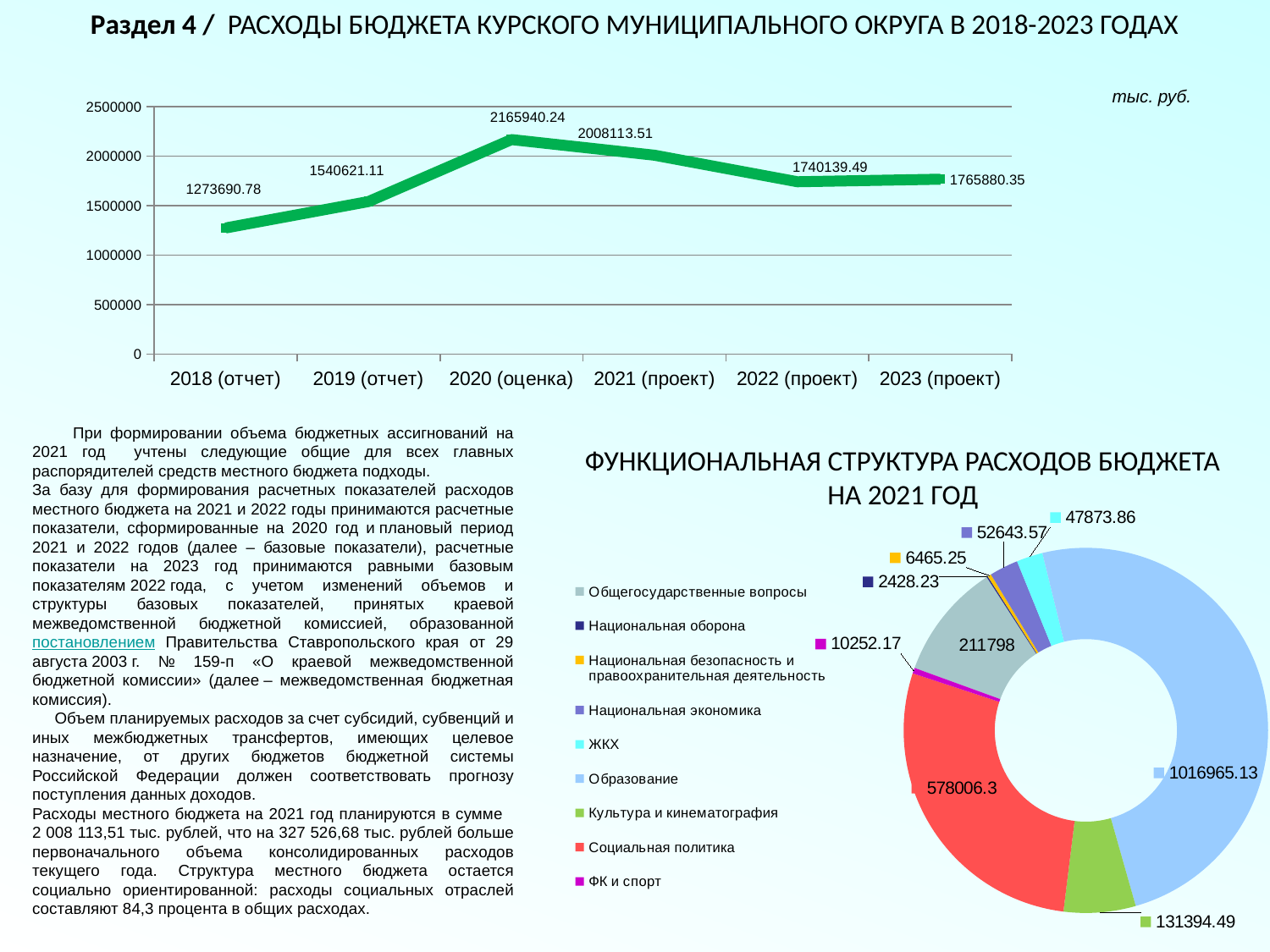
In the top line chart, what is the value for 2018 (отчет)? 1273690.78 What type of chart is the top chart showing budget expenditures for 2018-2023? line chart In the top line chart, which year has the lowest value? 2018 (отчет) In the chart 'ФУНКЦИОНАЛЬНАЯ СТРУКТУРА РАСХОДОВ БЮДЖЕТА НА 2021 ГОД', what is the value for Образование? 1016965.13 In the top line chart, do the values rise or fall from 2020 (оценка) to 2022 (проект)? fall In the top line chart, is the value for 2018 (отчет) greater or less than 1500000? less In the chart 'ФУНКЦИОНАЛЬНАЯ СТРУКТУРА РАСХОДОВ БЮДЖЕТА НА 2021 ГОД', which category has the smallest value? Национальная оборона How many categories does the legend of the chart 'ФУНКЦИОНАЛЬНАЯ СТРУКТУРА РАСХОДОВ БЮДЖЕТА НА 2021 ГОД' list? 9 In the top line chart, what is the value for 2020 (оценка)? 2165940.24 In the top line chart, which year has the highest value? 2020 (оценка) In the top line chart, how many years are plotted on the x axis? 6 In the top line chart, what is the difference between the values for 2020 (оценка) and 2021 (проект)? 157826.73